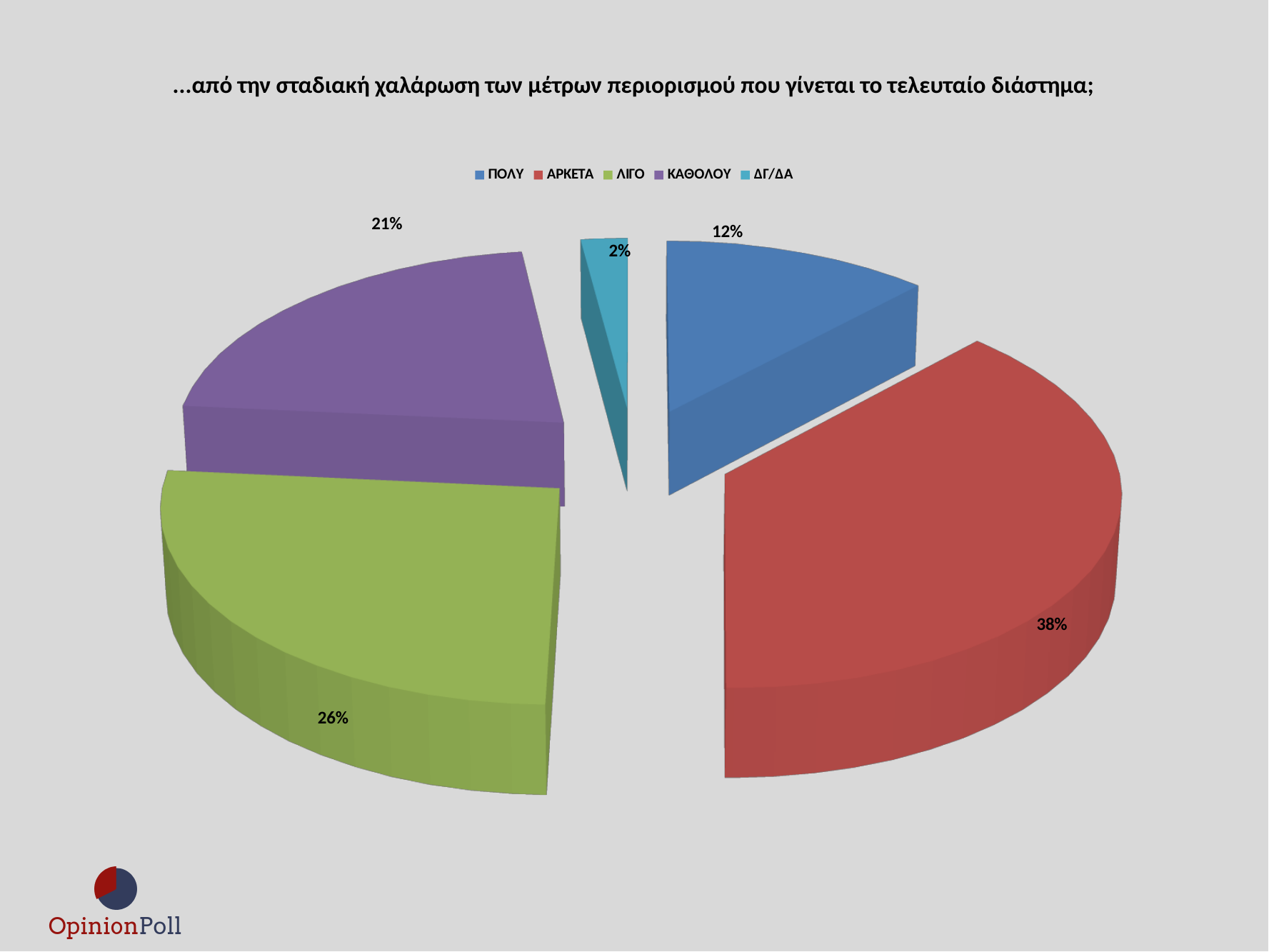
What is the difference in percentage points between ΑΡΚΕΤΑ and ΛΙΓΟ? 12 What colour is the slice for ΚΑΘΟΛΟΥ? Purple What percentage is shown for ΛΙΓΟ? 26% What percentage is shown for ΑΡΚΕΤΑ? 38% Which category has the smallest share of the pie? ΔΓ/ΔΑ How many categories does the legend list? 5 Which category has the largest share of the pie? ΑΡΚΕΤΑ What percentage is shown for ΠΟΛΥ? 12% What percentage is shown for ΔΓ/ΔΑ? 2% What type of chart is shown on the slide? Pie chart What percentage is shown for ΚΑΘΟΛΟΥ? 21% Which is larger, the share for ΛΙΓΟ or the share for ΚΑΘΟΛΟΥ? ΛΙΓΟ